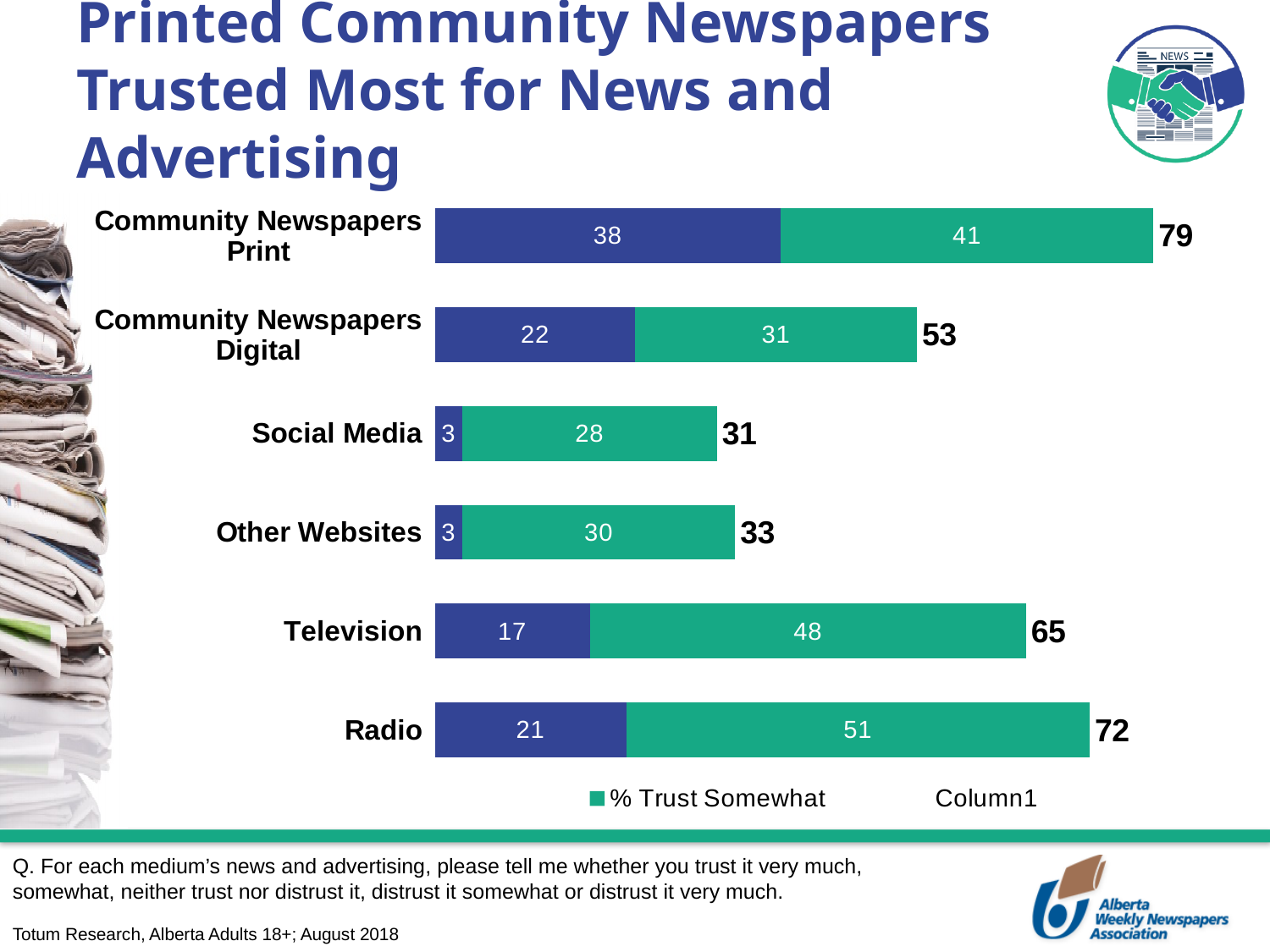
Which category has the highest % Trust Somewhat value? Radio What is the difference between the total for Community Newspapers Print and the total for Community Newspapers Digital? 26 Which has the larger total value, Television or Radio? Radio Which category has the lowest total value? Social Media What kind of chart is shown on the slide? bar chart Which category has the highest total value? Community Newspapers Print What is the total value printed for Other Websites? 33 How many entries does the chart legend list? 2 What is the total value printed at the end of the Radio bar? 72 How many media categories are plotted in the chart? 6 What is the % Trust Somewhat value for Television? 48 What is the % Trust Somewhat value for Community Newspapers Print? 41